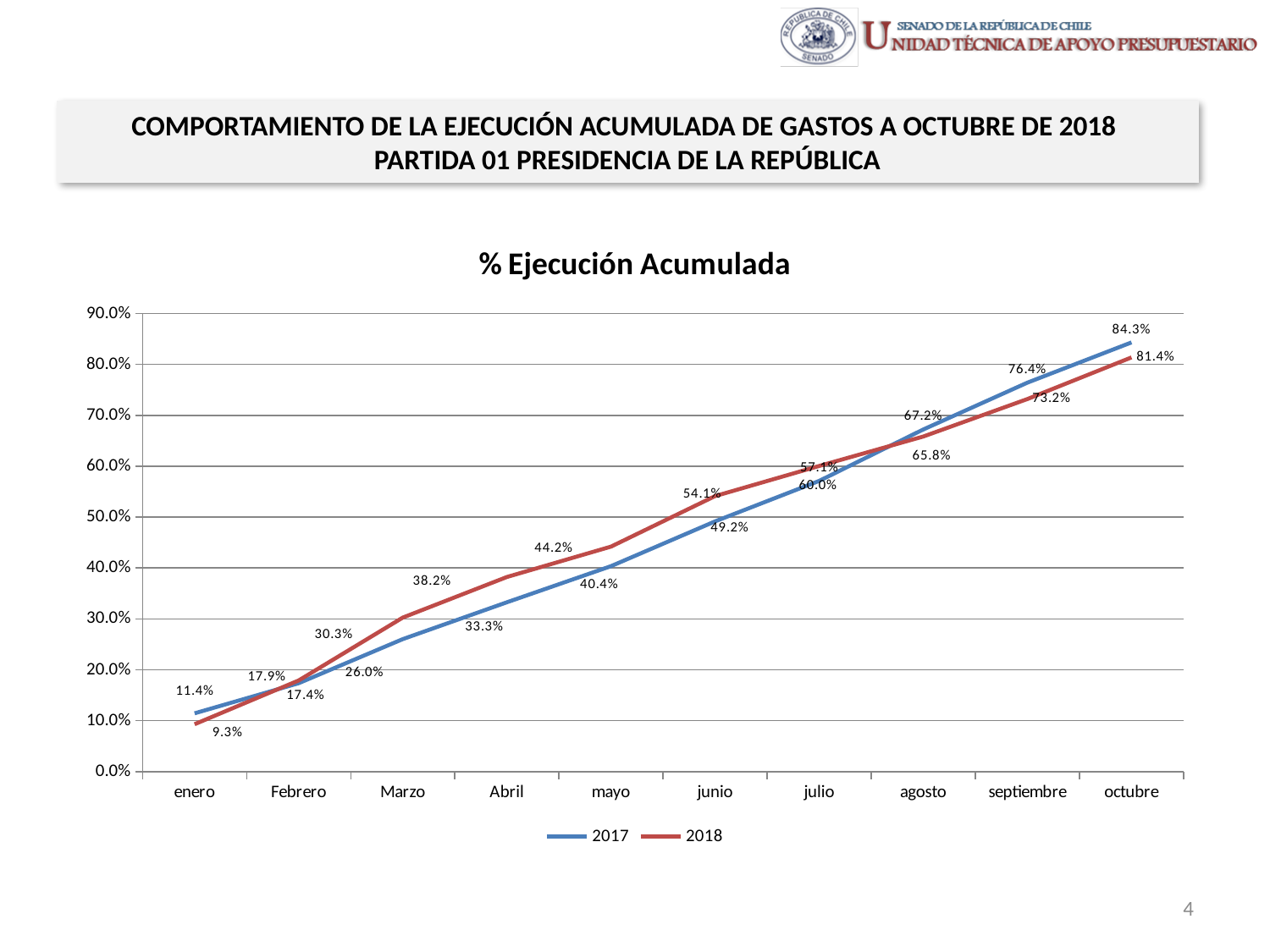
What is the value for 2017 in septiembre? 76.4% What is the value for 2018 in Abril? 38.2% What is the difference between the 2017 and 2018 values in octubre? 2.9 percentage points What is the value for 2018 in enero? 9.3% In Marzo, which series has the higher value, 2017 or 2018? 2018 In which month does the 2017 series have its lowest value? enero What kind of chart is shown on the slide? Line chart In which month does the 2018 series reach its highest value? octubre How many series does the legend of the chart list? 2 What is the value for 2017 in octubre? 84.3% How many months are shown on the x axis of the chart? 10 Do the values of the 2017 series rise or fall from enero to octubre? Rise